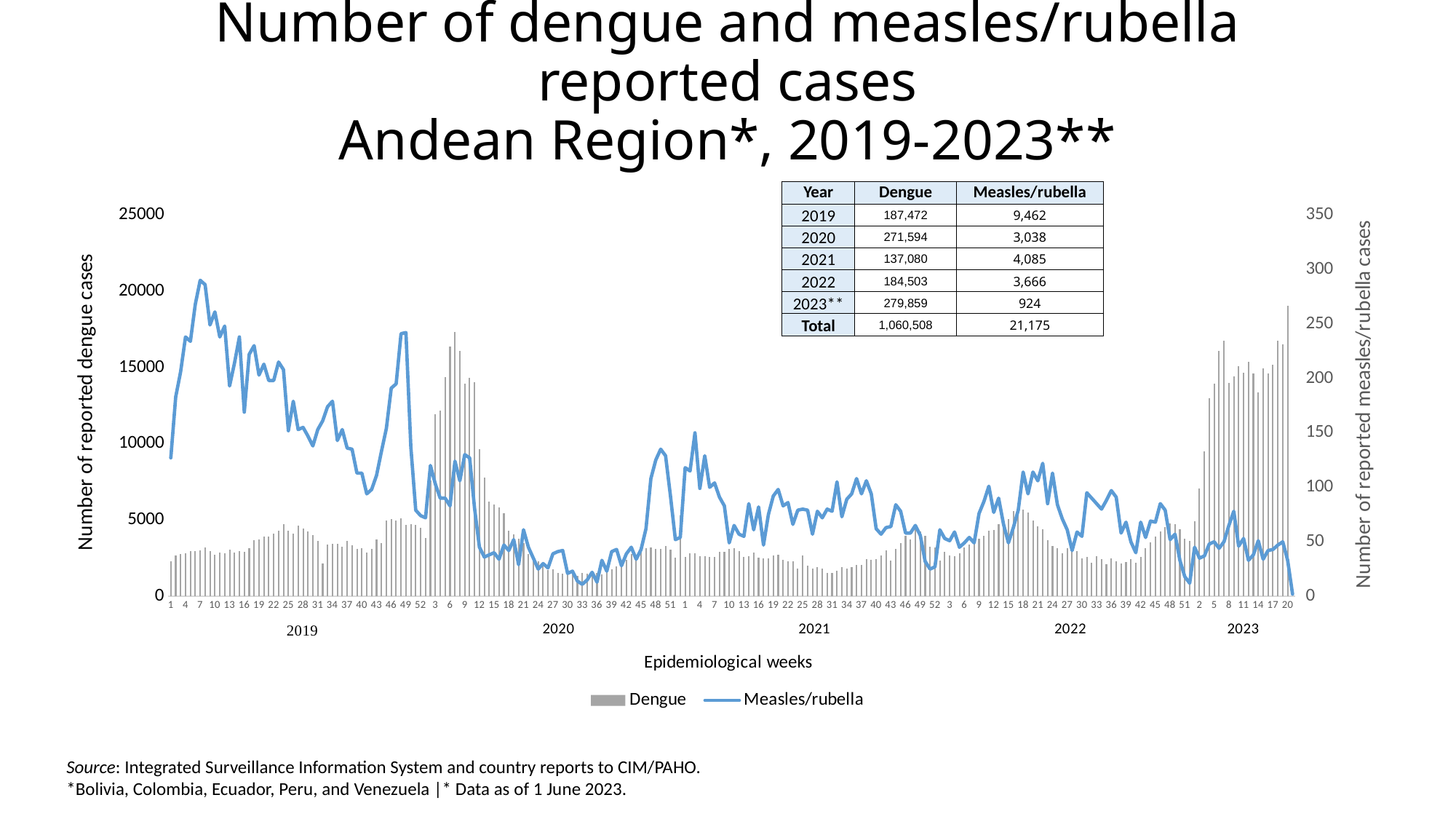
According to the table on the slide, how many measles/rubella cases were reported in 2019? 9,462 Which year in the table has the highest number of dengue cases? 2023** Is the peak of the measles/rubella line in 2019 greater or less than 250 on the right axis? greater What kind of chart is used to show the dengue and measles/rubella cases? A combined bar and line chart (bars for dengue, line for measles/rubella) How many series does the chart legend list? 2 Which year in the table has the lowest number of measles/rubella cases? 2023** What is the difference between the dengue cases in 2020 and in 2019 shown in the table? 84,122 Which year had more measles/rubella cases according to the table, 2021 or 2022? 2021 Do the dengue bars rise or fall across the weeks of 2023? rise According to the table on the slide, how many dengue cases were reported in 2020? 271,594 What is the label of the left vertical axis? Number of reported dengue cases What is the total number of dengue cases shown in the table? 1,060,508